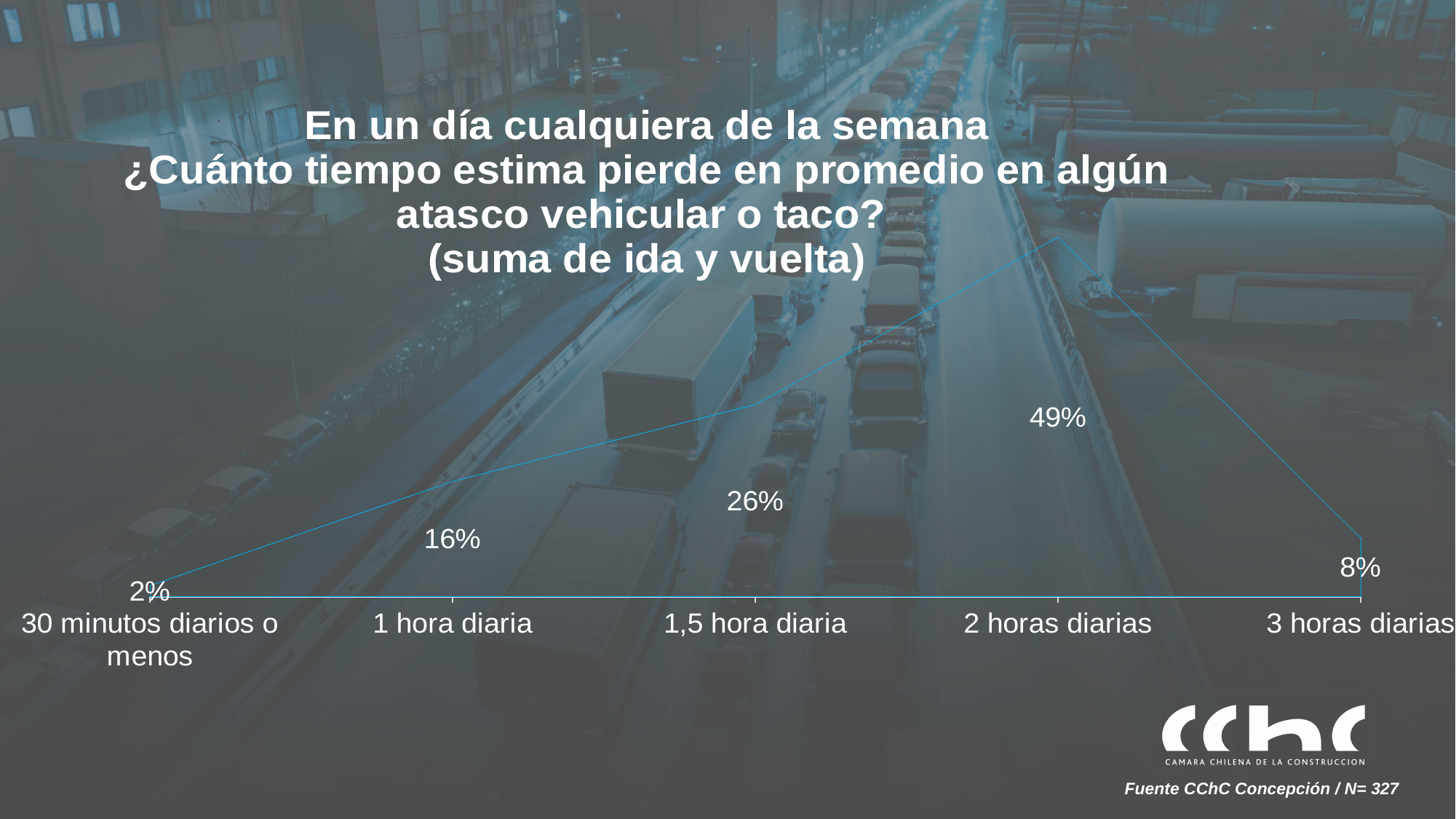
How many categories are shown on the x axis? 5 What percentage of respondents estimate losing 2 horas diarias in traffic jams? 49% Do the values rise or fall from '30 minutos diarios o menos' to '2 horas diarias'? rise What is the value for '3 horas diarias'? 8% What is the value for '30 minutos diarios o menos'? 2% Which category has the lowest value? 30 minutos diarios o menos Which is larger, the value for '1 hora diaria' or the value for '3 horas diarias'? 1 hora diaria What is the sample size (N) given in the source note on the slide? 327 What is the value for the category '1 hora diaria'? 16% Which category has the highest value? 2 horas diarias What kind of chart is shown on the slide? line chart What is the difference between the values for '2 horas diarias' and '1,5 hora diaria'? 23%